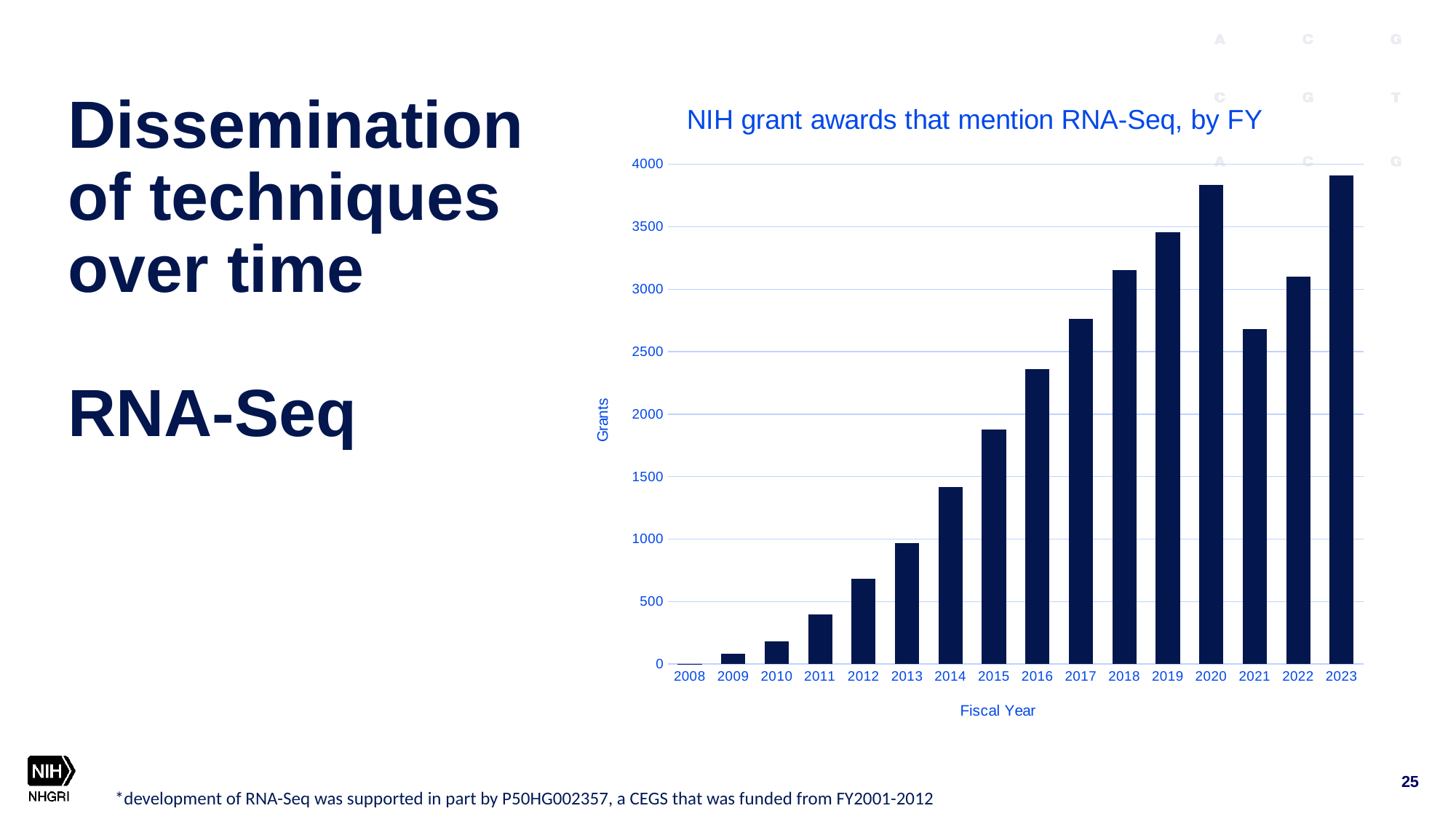
How many fiscal years are shown on the x axis of the chart? 16 What type of chart is shown on the slide? Bar chart Is the value for 2012 greater or less than 500? greater Is the value for 2016 greater or less than 2000? greater Which fiscal year has the highest number of grants? 2023 What is the label on the vertical axis of the chart? Grants Which fiscal year has more grants, 2020 or 2021? 2020 What is the title of the chart? NIH grant awards that mention RNA-Seq, by FY Which fiscal year has the lowest number of grants? 2008 Do the grant counts generally rise or fall from 2008 to 2020? Rise Is the value for 2021 greater or less than 2500? greater